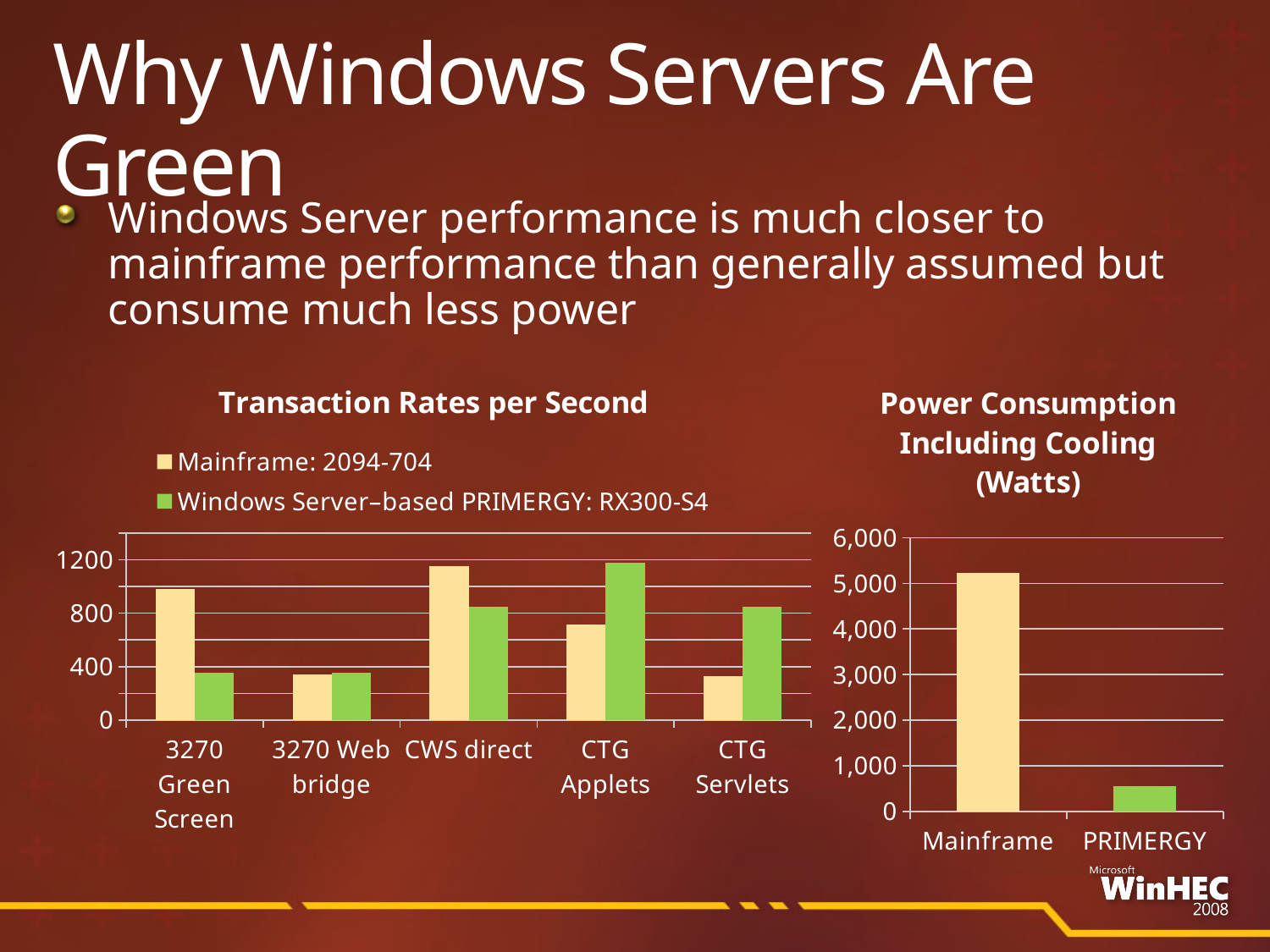
In the Power Consumption Including Cooling (Watts) chart, which category has the lowest value? PRIMERGY In the Transaction Rates per Second chart, is the Mainframe: 2094-704 value for 3270 Green Screen greater or less than 800? greater In the Transaction Rates per Second chart, which category has the highest Mainframe: 2094-704 value? CWS direct In the Transaction Rates per Second chart, for CTG Applets, which series has the larger value? Windows Server–based PRIMERGY: RX300-S4 In the Power Consumption Including Cooling (Watts) chart, is the value for Mainframe greater or less than 5,000? greater How many series does the legend of the Transaction Rates per Second chart list? 2 In the Transaction Rates per Second chart, is the Windows Server–based PRIMERGY: RX300-S4 value for CTG Servlets greater or less than 400? greater In the Transaction Rates per Second chart, which category has the highest Windows Server–based PRIMERGY: RX300-S4 value? CTG Applets How many categories are shown on the x axis of the Transaction Rates per Second chart? 5 In the Transaction Rates per Second chart, for CWS direct, which series has the larger value? Mainframe: 2094-704 What kind of chart is the Transaction Rates per Second chart? bar chart